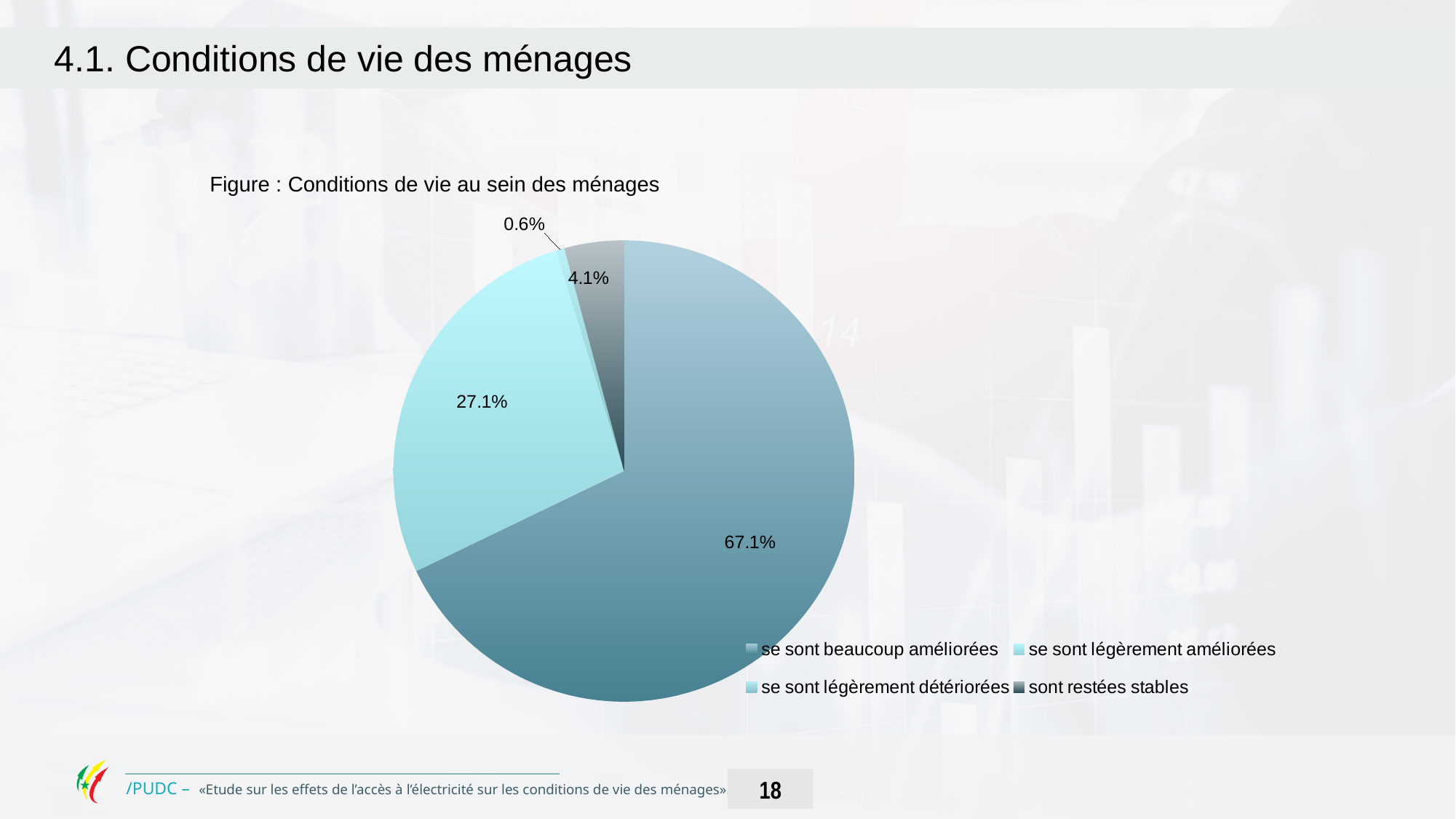
What share of the pie is labelled for 'se sont légèrement améliorées'? 27.1% What share of the pie is labelled for 'se sont légèrement détériorées'? 0.6% Which category has the largest slice of the pie? se sont beaucoup améliorées What is the difference between the shares for 'se sont beaucoup améliorées' and 'se sont légèrement améliorées'? 40.0 percentage points How many slices does the pie chart have? 4 How many categories does the legend of the pie chart list? 4 What is the title of the figure on the slide? Figure : Conditions de vie au sein des ménages Which is larger: the share for 'sont restées stables' or the share for 'se sont légèrement détériorées'? sont restées stables What type of chart is shown on the slide? pie chart Which category has the smallest slice of the pie? se sont légèrement détériorées What share of the pie is labelled for 'se sont beaucoup améliorées'? 67.1%